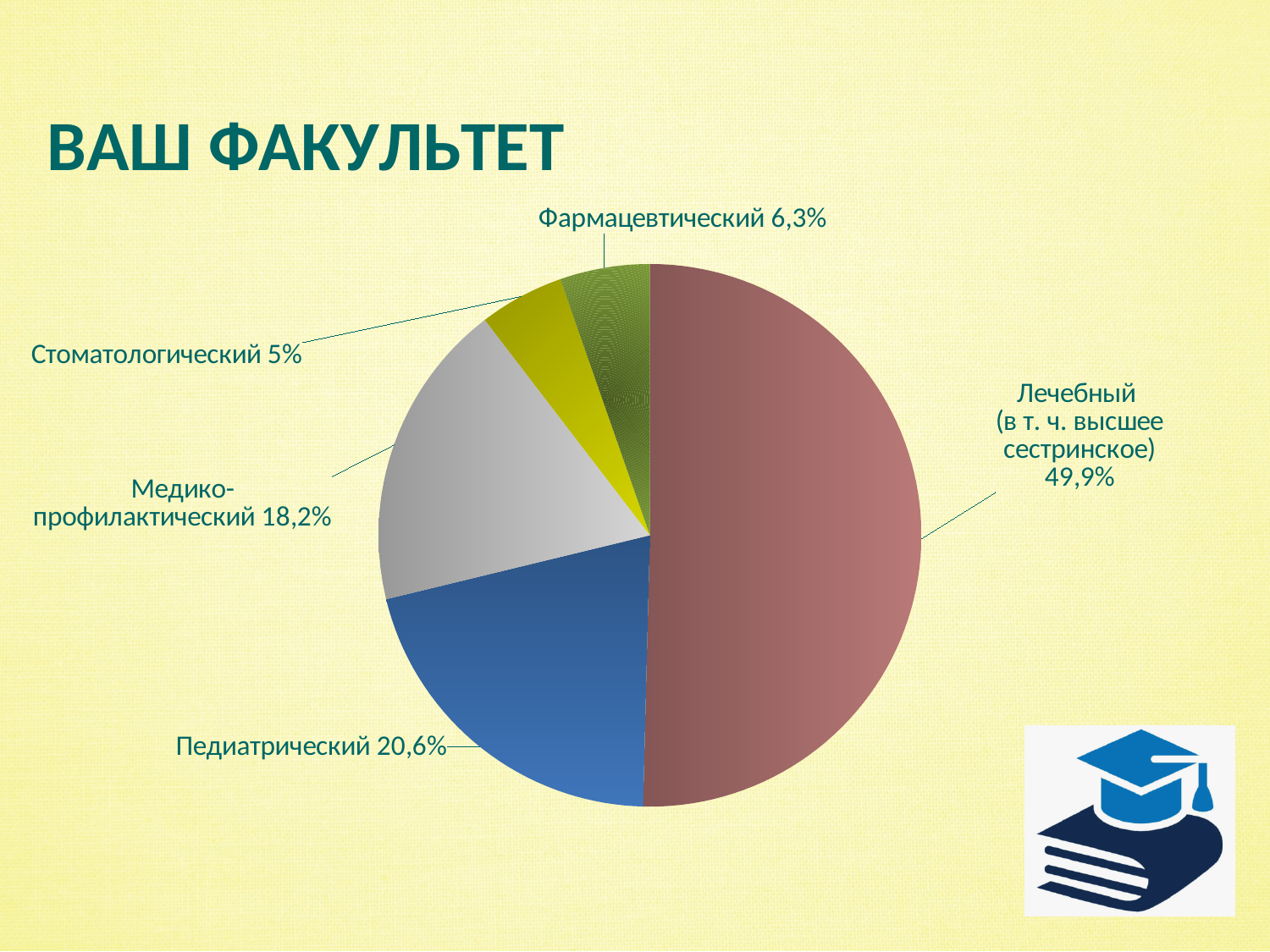
Which faculty has the smallest share of the pie? Стоматологический What is the title of the slide? ВАШ ФАКУЛЬТЕТ Which faculty has the largest share of the pie? Лечебный (в т. ч. высшее сестринское) What kind of chart is shown on the slide? Pie chart What is the value shown for Медико-профилактический? 18,2% What is the value shown for Педиатрический? 20,6% Which is larger, the share for Фармацевтический or the share for Стоматологический? Фармацевтический What is the value shown for Фармацевтический? 6,3% What is the difference in percentage points between Педиатрический and Медико-профилактический? 2,4 What is the value shown for Стоматологический? 5% What share of the pie does Лечебный (в т. ч. высшее сестринское) have? 49,9% How many slices does the pie chart have? 5